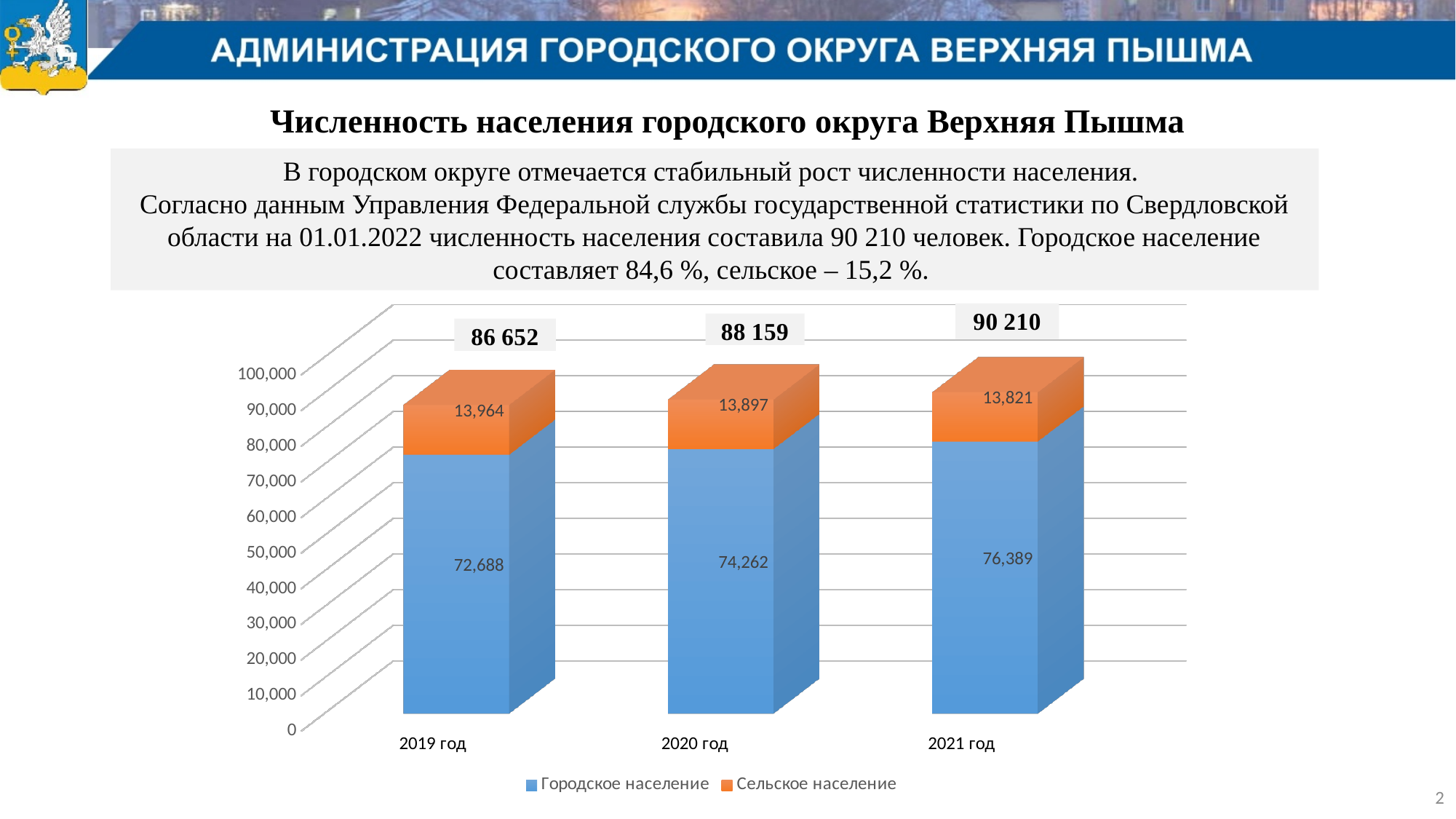
What is the difference between the Городское население values for 2021 год and 2019 год? 3,701 What is the value for Сельское население in 2021 год? 13,821 How many series does the chart legend list? 2 Which is larger: Сельское население in 2019 год or in 2020 год? 2019 год Which year has the lowest value for Сельское население? 2021 год What is the total population shown above the bar for 2019 год? 86 652 What is the value for Городское население in 2019 год? 72,688 Does the Городское население value rise or fall from 2019 год to 2021 год? rise What is the total population shown above the bar for 2021 год? 90 210 What is the value for Городское население in 2020 год? 74,262 Which year has the highest value for Городское население? 2021 год How many years are shown on the x axis of the chart? 3